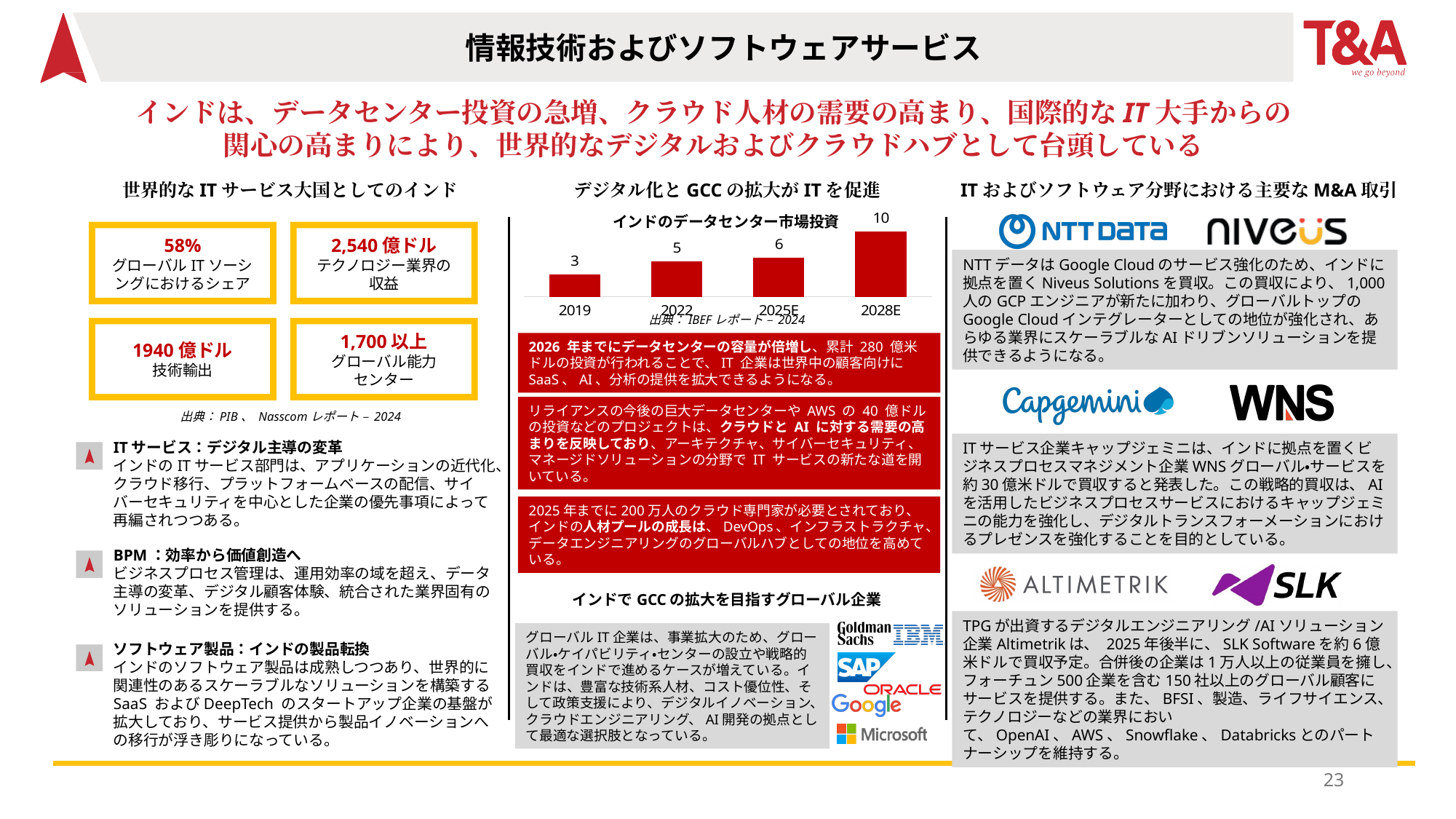
What is the value for 2028E in the インドのデータセンター市場投資 chart? 10 How many categories are shown in the インドのデータセンター市場投資 chart? 4 What is the difference between the values for 2025E and 2022 in the インドのデータセンター市場投資 chart? 1 In the インドのデータセンター市場投資 chart, which is larger, the value for 2022 or the value for 2028E? 2028E Do the values in the インドのデータセンター市場投資 chart rise or fall from 2019 to 2028E? rise What is the value for 2022 in the インドのデータセンター市場投資 chart? 5 What is the value for 2025E in the インドのデータセンター市場投資 chart? 6 What is the difference between the values for 2028E and 2019 in the インドのデータセンター市場投資 chart? 7 Which category has the lowest value in the インドのデータセンター市場投資 chart? 2019 Which category has the highest value in the インドのデータセンター市場投資 chart? 2028E What is the value for 2019 in the インドのデータセンター市場投資 chart? 3 What kind of chart is the インドのデータセンター市場投資 chart? bar chart